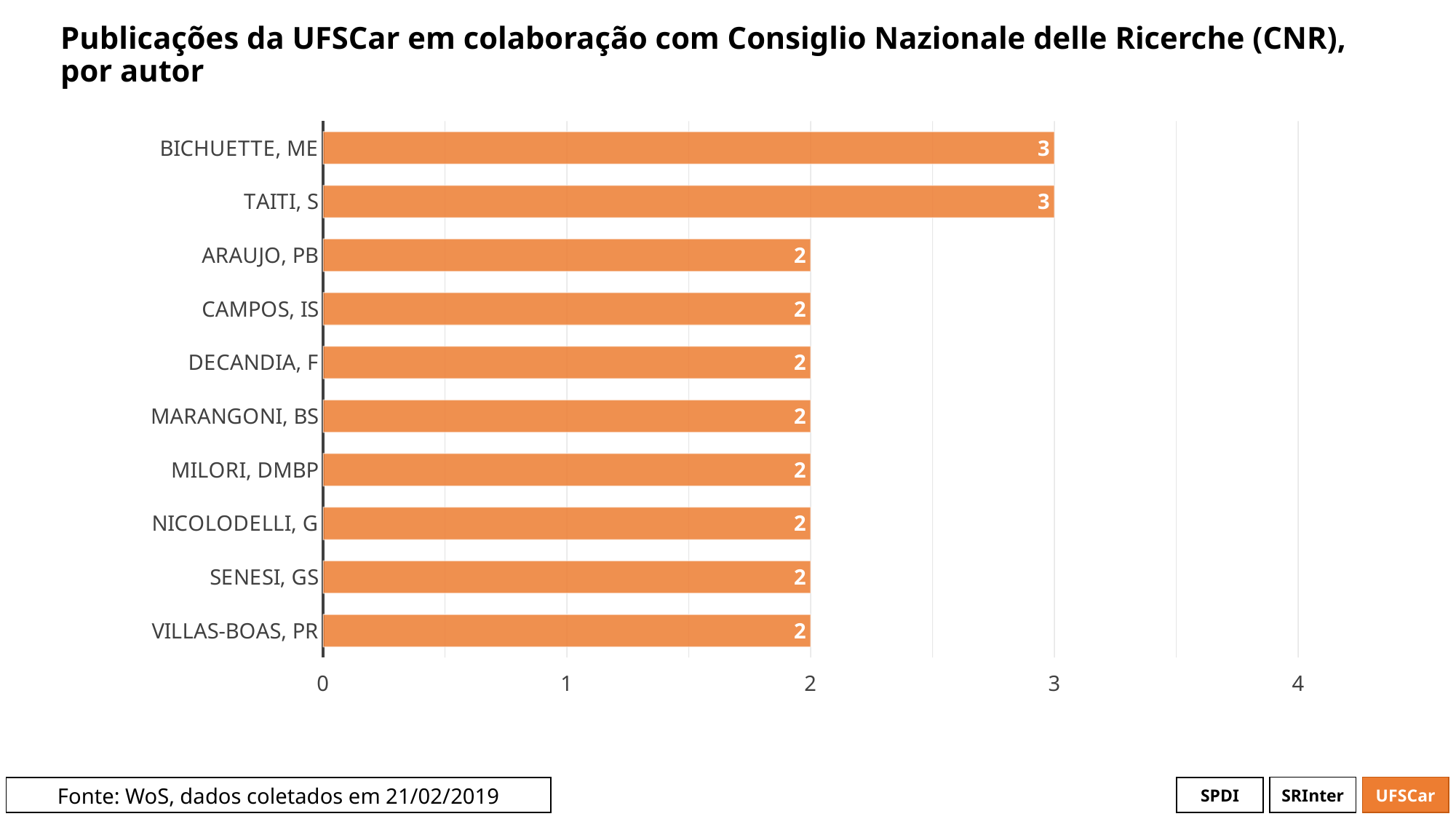
How many authors have a value of 3? 2 What is the value for BICHUETTE, ME? 3 What is the difference between the values for TAITI, S and SENESI, GS? 1 What is the value for TAITI, S? 3 How many authors are shown in the chart? 10 What is the data source stated on the slide? WoS, dados coletados em 21/02/2019 What is the value for VILLAS-BOAS, PR? 2 What kind of chart is shown on the slide? bar chart What is the title of the chart? Publicações da UFSCar em colaboração com Consiglio Nazionale delle Ricerche (CNR), por autor Which is larger, the value for BICHUETTE, ME or the value for MILORI, DMBP? BICHUETTE, ME Is the value for NICOLODELLI, G greater or less than 3? less What is the value for ARAUJO, PB? 2